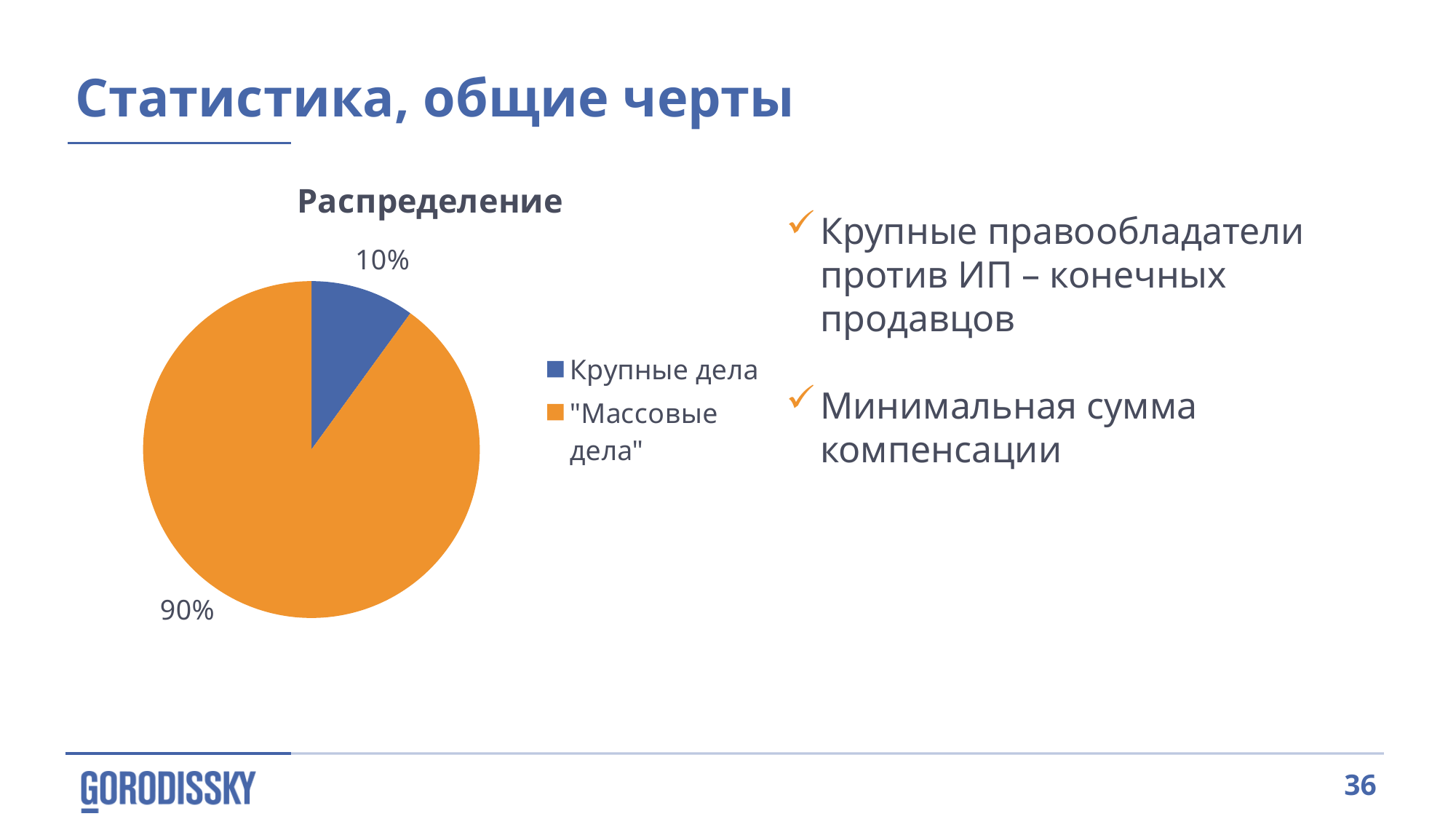
Which is larger, the share for "Крупные дела" or the share for "Массовые дела"? "Массовые дела" What is the difference in percentage points between "Массовые дела" and "Крупные дела"? 80 percentage points How many categories does the pie chart show? 2 What share of the pie is labelled "Массовые дела"? 90% What share of the pie is labelled "Крупные дела"? 10% Which category has the smallest slice of the pie? Крупные дела What kind of chart is shown on the slide? pie chart What colour is the slice for "Крупные дела"? blue Which category has the largest slice of the pie? "Массовые дела" How many entries does the legend list? 2 What is the title of the chart? Распределение